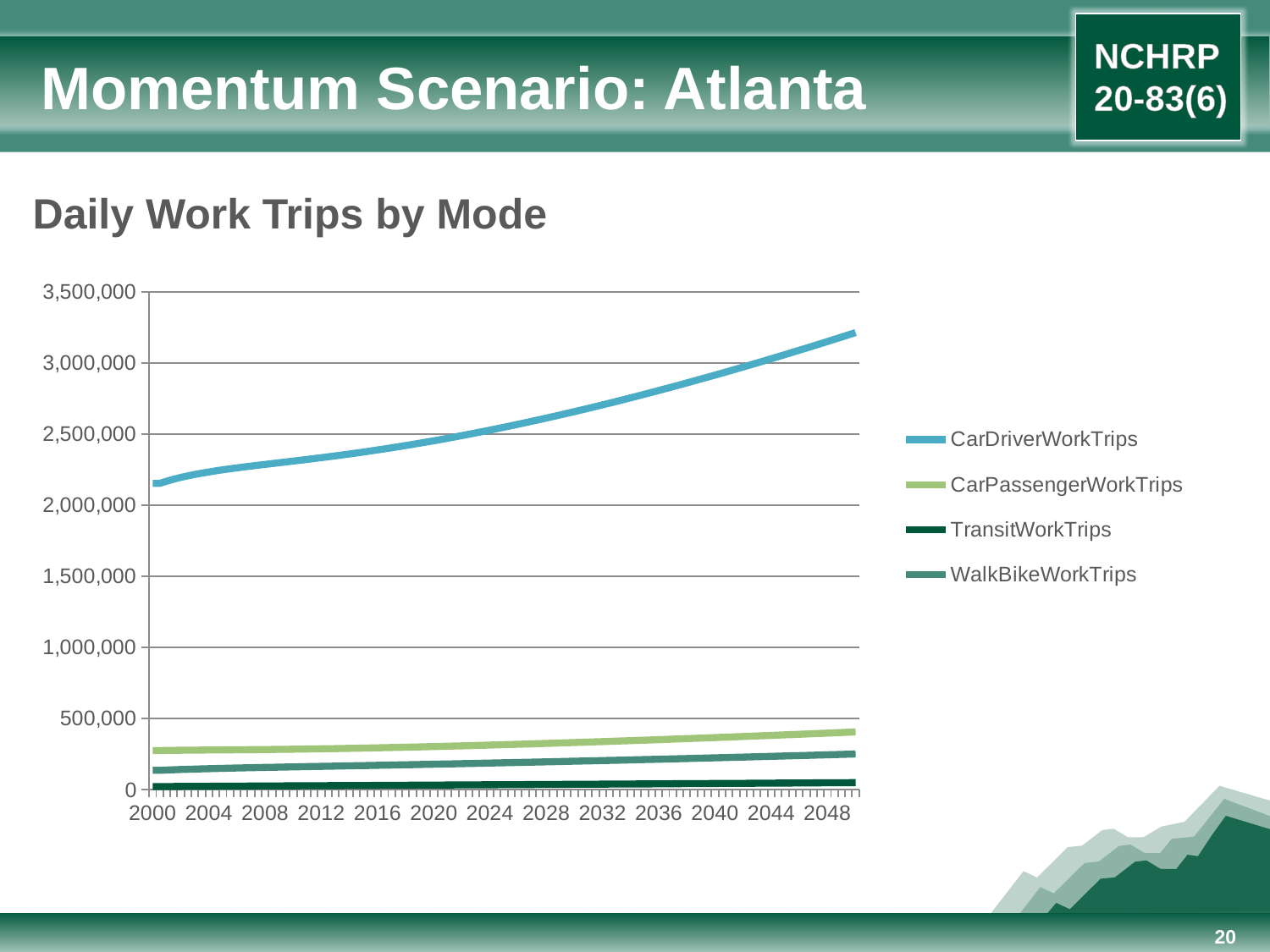
What is the first year shown on the x axis? 2000 Which series has the lowest values throughout the chart? TransitWorkTrips Do the CarDriverWorkTrips values rise or fall from 2000 to 2048? rise Which series is larger in 2000, WalkBikeWorkTrips or TransitWorkTrips? WalkBikeWorkTrips Is the value for CarDriverWorkTrips in 2048 greater or less than 3,000,000? greater Which series is larger in 2048, CarPassengerWorkTrips or WalkBikeWorkTrips? CarPassengerWorkTrips What is the title of the chart? Daily Work Trips by Mode What kind of chart is shown on the slide? line chart Is the value for CarPassengerWorkTrips in 2048 greater or less than 500,000? less Which series has the highest values throughout the chart? CarDriverWorkTrips Is the value for CarDriverWorkTrips in 2000 greater or less than 2,000,000? greater How many series does the legend list? 4